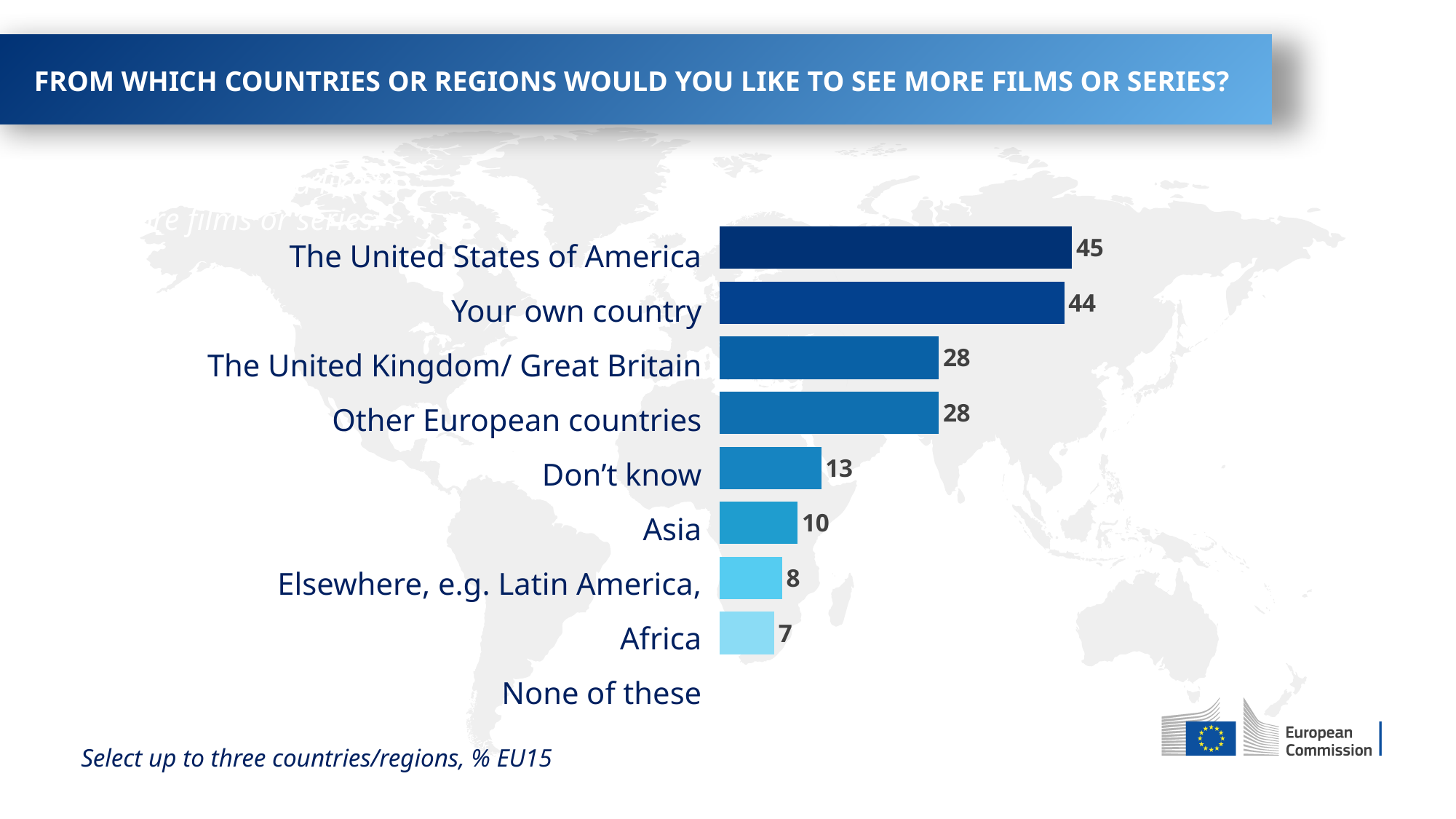
What is the value for The United States of America? 45 Which has a larger value, Don't know or Elsewhere, e.g. Latin America? Don't know How many bars have a printed value on the chart? 8 What is the difference between the values for The United States of America and Your own country? 1 What is the title of the chart? From which countries or regions would you like to see more films or series? Which has a larger value, Asia or Africa? Asia What is the value for Your own country? 44 What is the value for Don't know? 13 What kind of chart is shown on the slide? Bar chart What is the difference between the values for Other European countries and Don't know? 15 Which category has the highest value? The United States of America